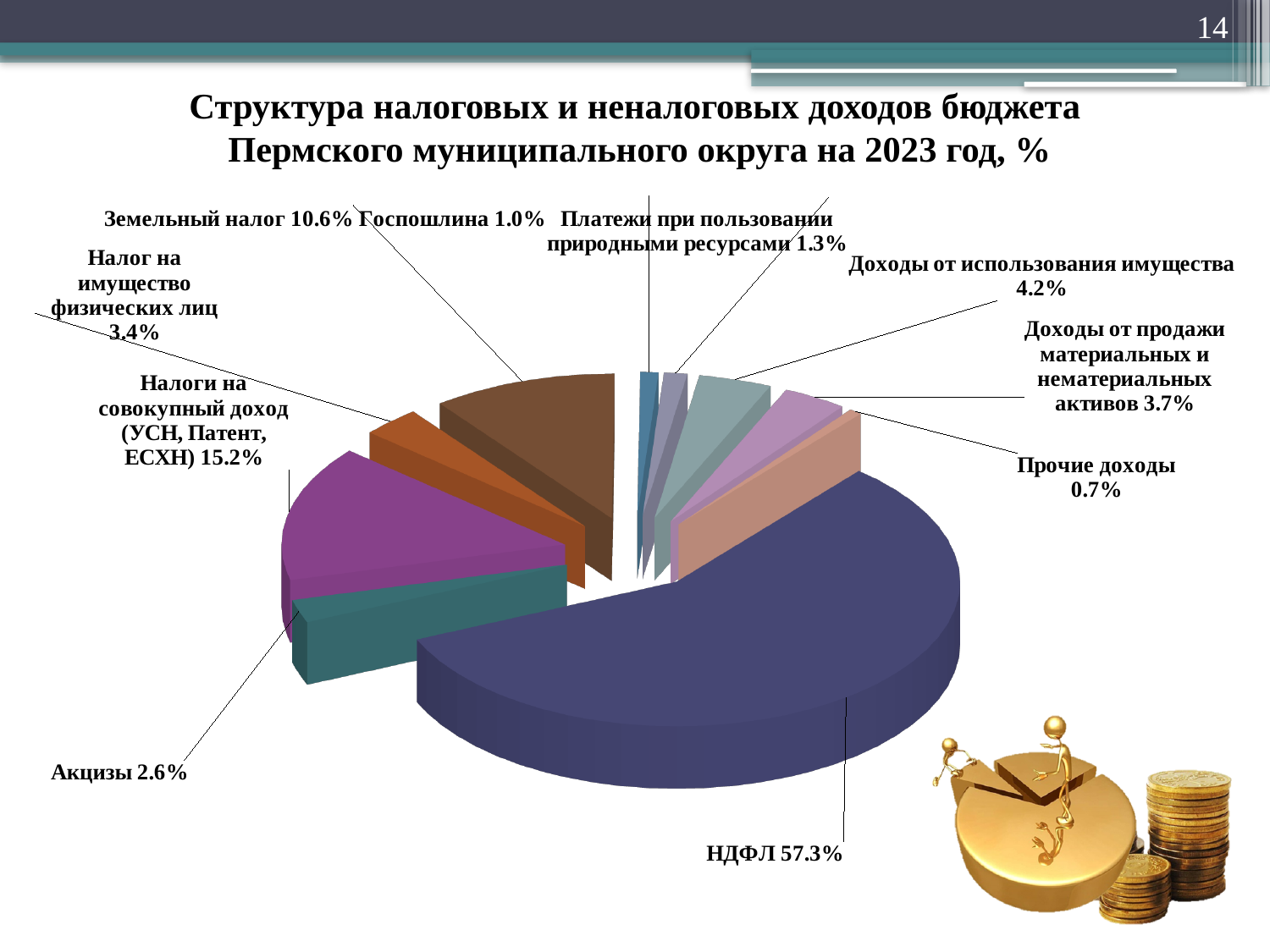
What is the share of Земельный налог? 10.6% Which is larger: Доходы от использования имущества or Доходы от продажи материальных и нематериальных активов? Доходы от использования имущества Which category has the largest share of the pie? НДФЛ Which category has the smallest share of the pie? Прочие доходы How many categories are shown in the pie chart? 10 What is the share of Акцизы? 2.6% What share of the budget revenue does НДФЛ account for? 57.3% What is the difference in percentage points between НДФЛ and Налоги на совокупный доход (УСН, Патент, ЕСХН)? 42.1 What kind of chart is shown on the slide? Pie chart For which year does the chart show the structure of tax and non-tax budget revenues? 2023 What is the share of Налоги на совокупный доход (УСН, Патент, ЕСХН)? 15.2% What is the share of Доходы от использования имущества? 4.2%